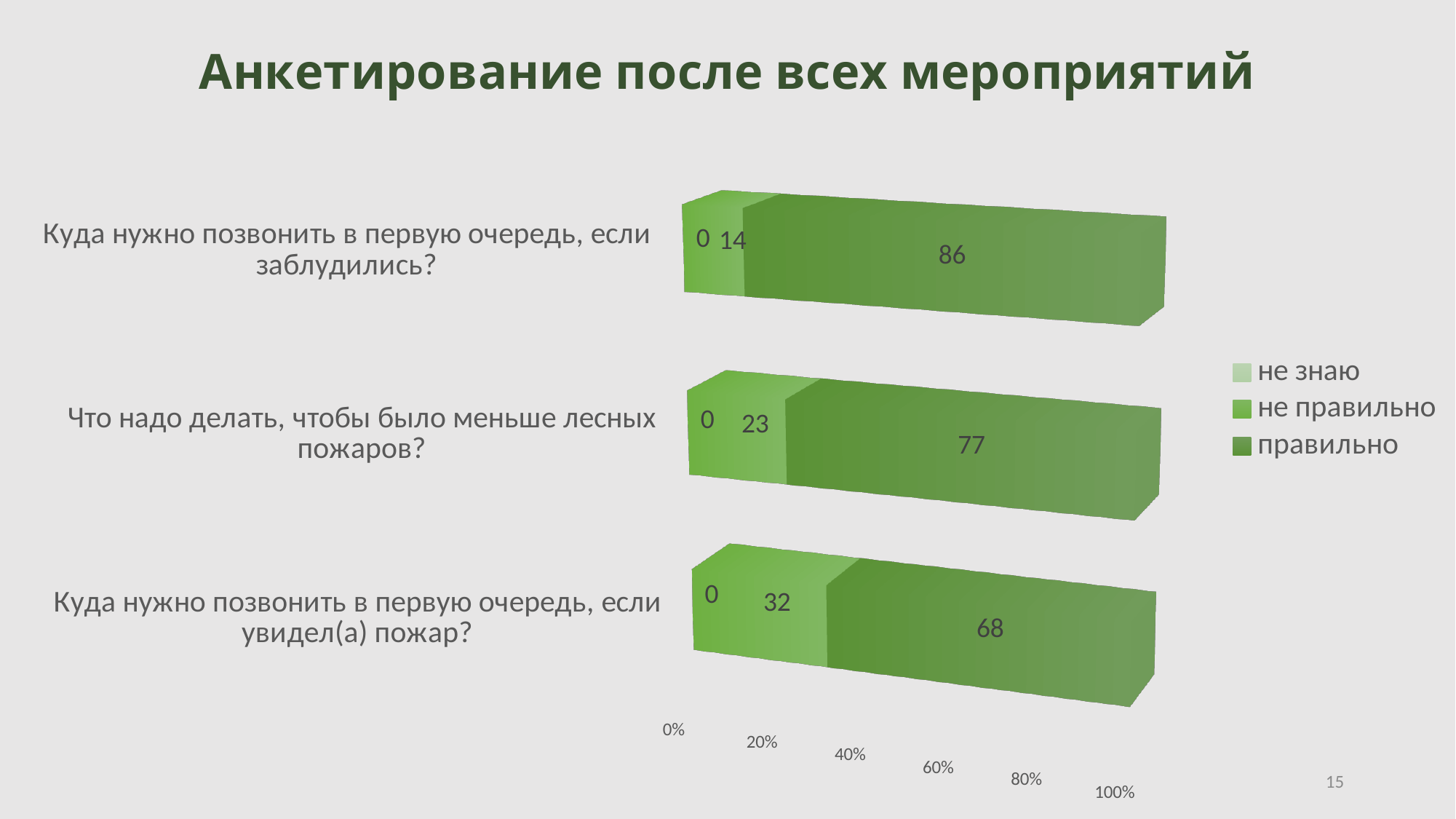
How many questions (categories) are shown in the chart? 3 What is the value for "правильно" for the question "Куда нужно позвонить в первую очередь, если заблудились?"? 86 What is the difference between the "правильно" values for "Куда нужно позвонить в первую очередь, если заблудились?" and "Куда нужно позвонить в первую очередь, если увидел(а) пожар?"? 18 What kind of chart is shown on the slide? Stacked bar chart Which question has the highest value for "правильно"? Куда нужно позвонить в первую очередь, если заблудились? What is the value for "не правильно" for the question "Куда нужно позвонить в первую очередь, если увидел(а) пожар?"? 32 What is the total of the stacked bar for "Что надо делать, чтобы было меньше лесных пожаров?"? 100 Which is larger: the "не правильно" value for "Что надо делать, чтобы было меньше лесных пожаров?" or for "Куда нужно позвонить в первую очередь, если заблудились?"? Что надо делать, чтобы было меньше лесных пожаров? What is the value for "не правильно" for the question "Что надо делать, чтобы было меньше лесных пожаров?"? 23 Which question has the lowest value for "правильно"? Куда нужно позвонить в первую очередь, если увидел(а) пожар? What is the value for "не знаю" for the question "Что надо делать, чтобы было меньше лесных пожаров?"? 0 How many series does the legend list? 3